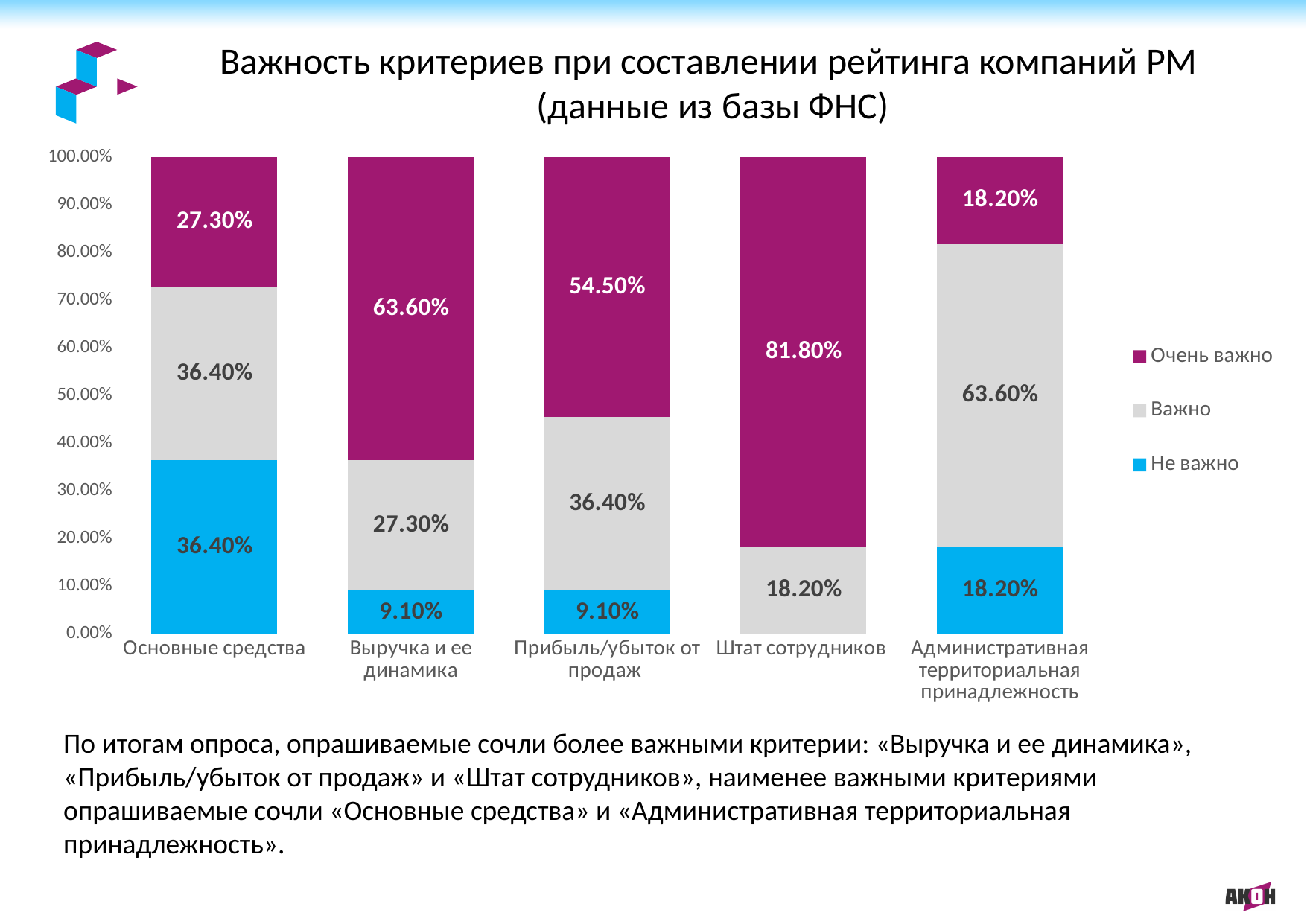
What is the 'Очень важно' value for 'Штат сотрудников'? 81.80% What is the difference between the 'Очень важно' values for 'Выручка и ее динамика' and 'Основные средства'? 36.30% How many series does the legend list? 3 What is the 'Очень важно' value for 'Прибыль/убыток от продаж'? 54.50% Which category has the lowest 'Очень важно' value? Административная территориальная принадлежность What kind of chart is shown on the slide? Stacked bar chart Which is larger: the 'Важно' value for 'Прибыль/убыток от продаж' or for 'Выручка и ее динамика'? Прибыль/убыток от продаж Which category has the highest 'Очень важно' value? Штат сотрудников What is the 'Важно' value for 'Административная территориальная принадлежность'? 63.60% What is the 'Не важно' value for 'Основные средства'? 36.40% How many categories are shown on the x axis? 5 Which colour represents the 'Не важно' series in the legend? Blue